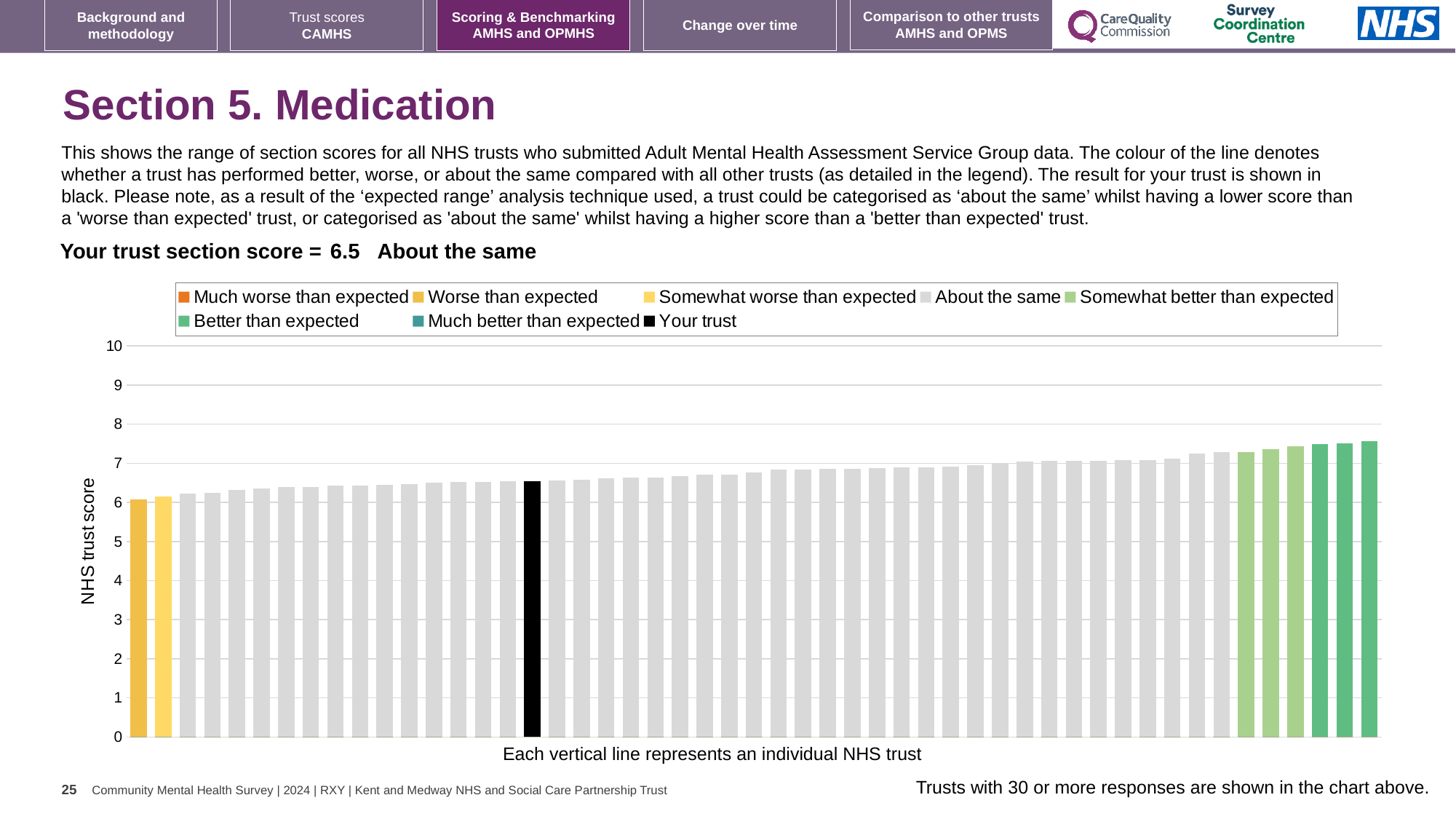
Which category is your trust placed in for this section? About the same What colour is the bar representing your trust? black How many bars in the chart are shaded green? 6 What kind of chart is shown on the slide? bar chart Is the value of the rightmost (highest) bar greater or less than 7? greater What is the section score for your trust? 6.5 Is the value of the rightmost (highest) bar greater or less than 8? less Do the bar values rise or fall from left to right along the x axis? rise Is the value of the leftmost (lowest) bar greater or less than 7? less How many entries does the chart legend list? 8 What is the label on the vertical axis of the chart? NHS trust score